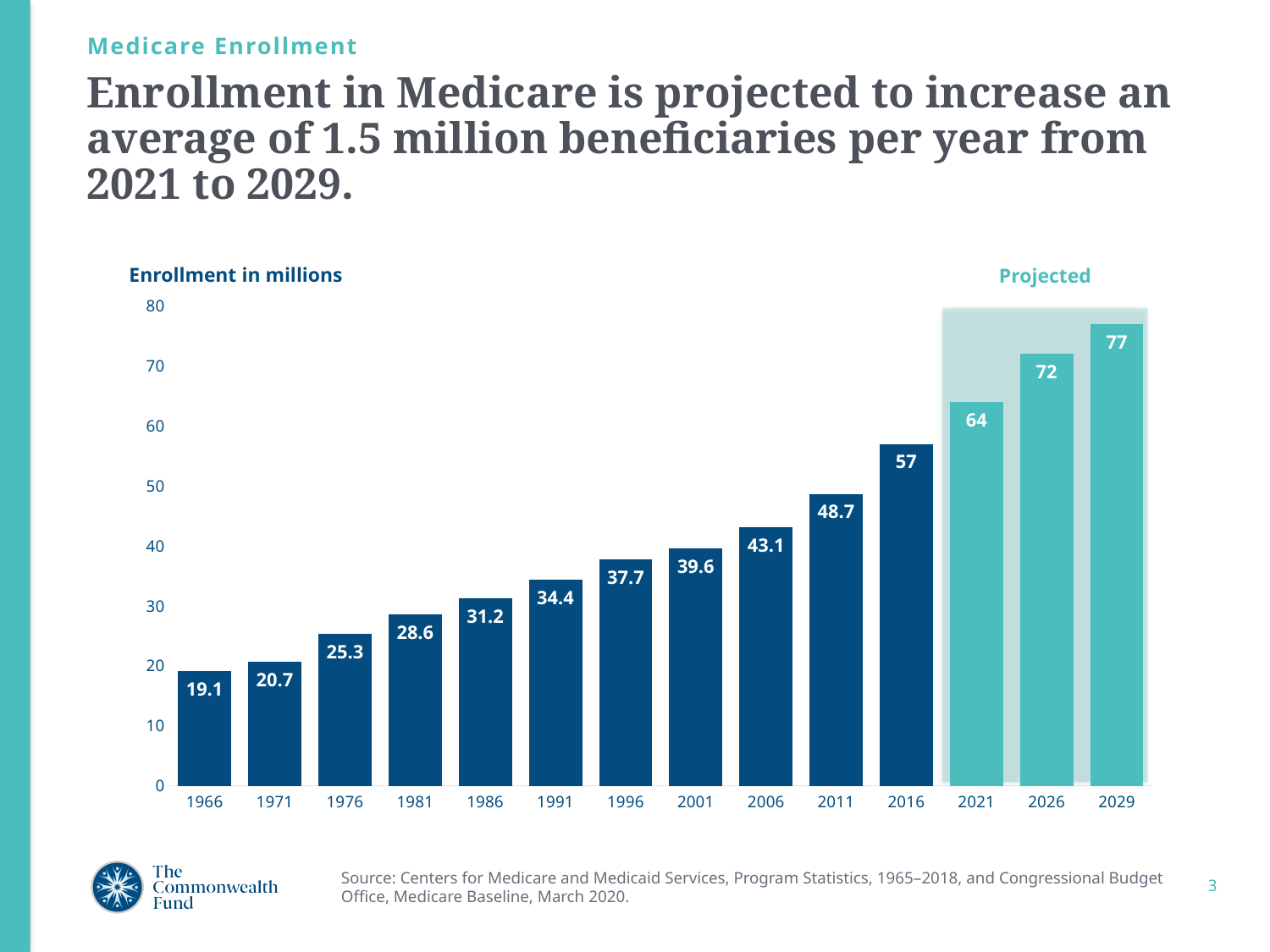
What kind of chart is shown on the slide? Bar chart Is the enrollment value for 2021 greater or less than 60? greater What is the difference in enrollment (in millions) between 2011 and 2006? 5.6 What is the projected Medicare enrollment in millions for 2029? 77 What is the Medicare enrollment in millions for 1966? 19.1 Do the enrollment values rise or fall from 1966 to 2029? Rise What is the difference in enrollment (in millions) between 2029 and 2021? 13 Which year has the lowest enrollment value on the chart? 1966 How many years are shown on the x axis of the chart? 14 Which year has a larger enrollment value, 1996 or 2001? 2001 Which year has the highest enrollment value on the chart? 2029 What is the Medicare enrollment in millions for 2016? 57